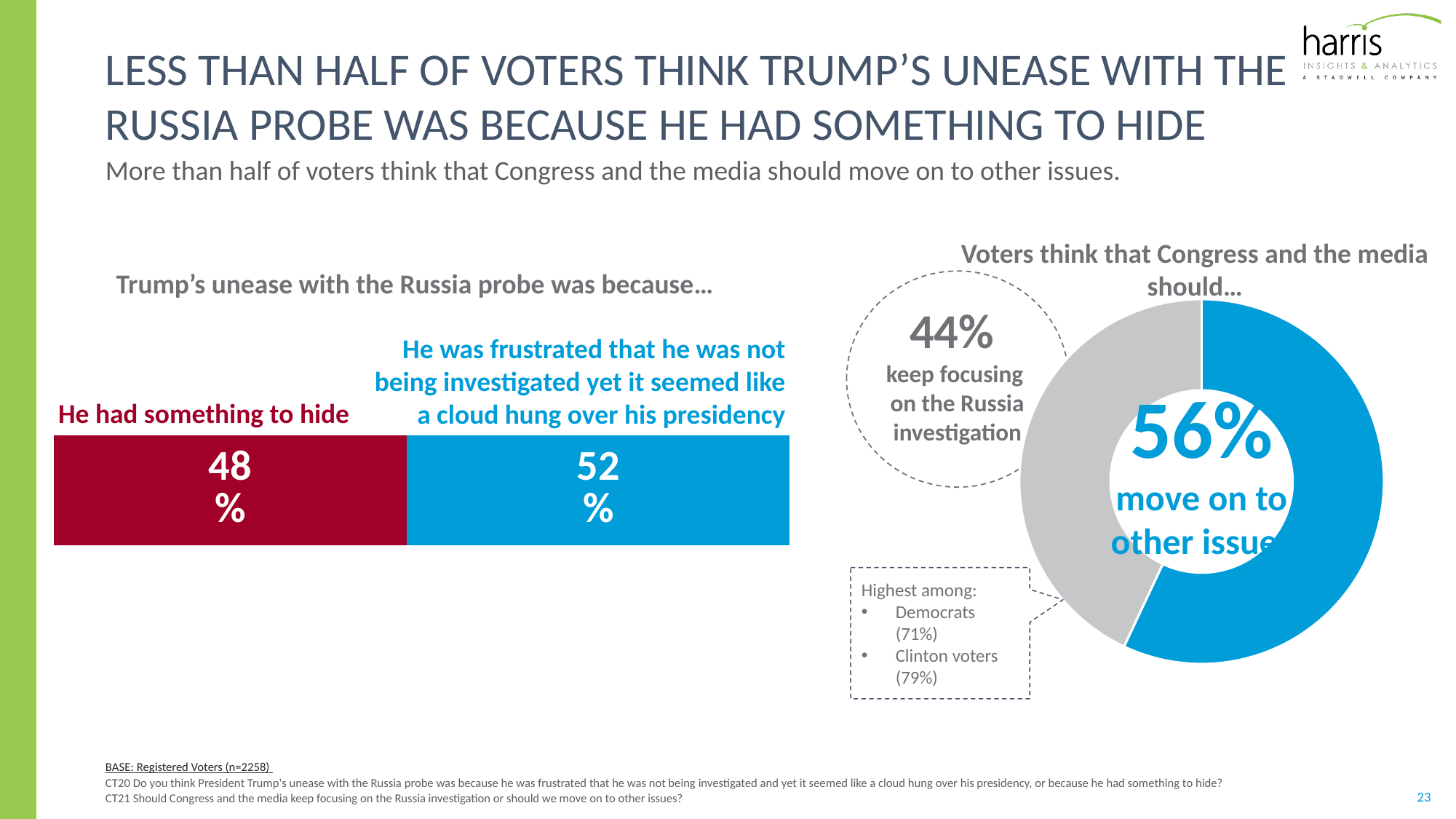
In the chart titled "Voters think that Congress and the media should...", how many percentage points larger is "move on to other issues" than "keep focusing on the Russia investigation"? 12 In the chart titled "Trump's unease with the Russia probe was because...", what is the difference in percentage points between the two responses? 4 What kind of chart is used for "Trump's unease with the Russia probe was because..."? Stacked bar chart What kind of chart is used for "Voters think that Congress and the media should..."? Donut chart In the chart titled "Trump's unease with the Russia probe was because...", what percentage of voters said he had something to hide? 48% In the chart titled "Voters think that Congress and the media should...", what percentage of voters think they should keep focusing on the Russia investigation? 44% In the chart titled "Trump's unease with the Russia probe was because...", what colour is the segment for "He had something to hide"? Red In the chart titled "Trump's unease with the Russia probe was because...", what is the total of the two segments of the bar? 100% In the chart titled "Trump's unease with the Russia probe was because...", what percentage of voters said he was frustrated that he was not being investigated yet it seemed like a cloud hung over his presidency? 52% In the chart titled "Voters think that Congress and the media should...", which option has the smaller share? Keep focusing on the Russia investigation In the chart titled "Trump's unease with the Russia probe was because...", which response has the larger share? He was frustrated that he was not being investigated yet it seemed like a cloud hung over his presidency In the chart titled "Voters think that Congress and the media should...", what percentage of voters think they should move on to other issues? 56%